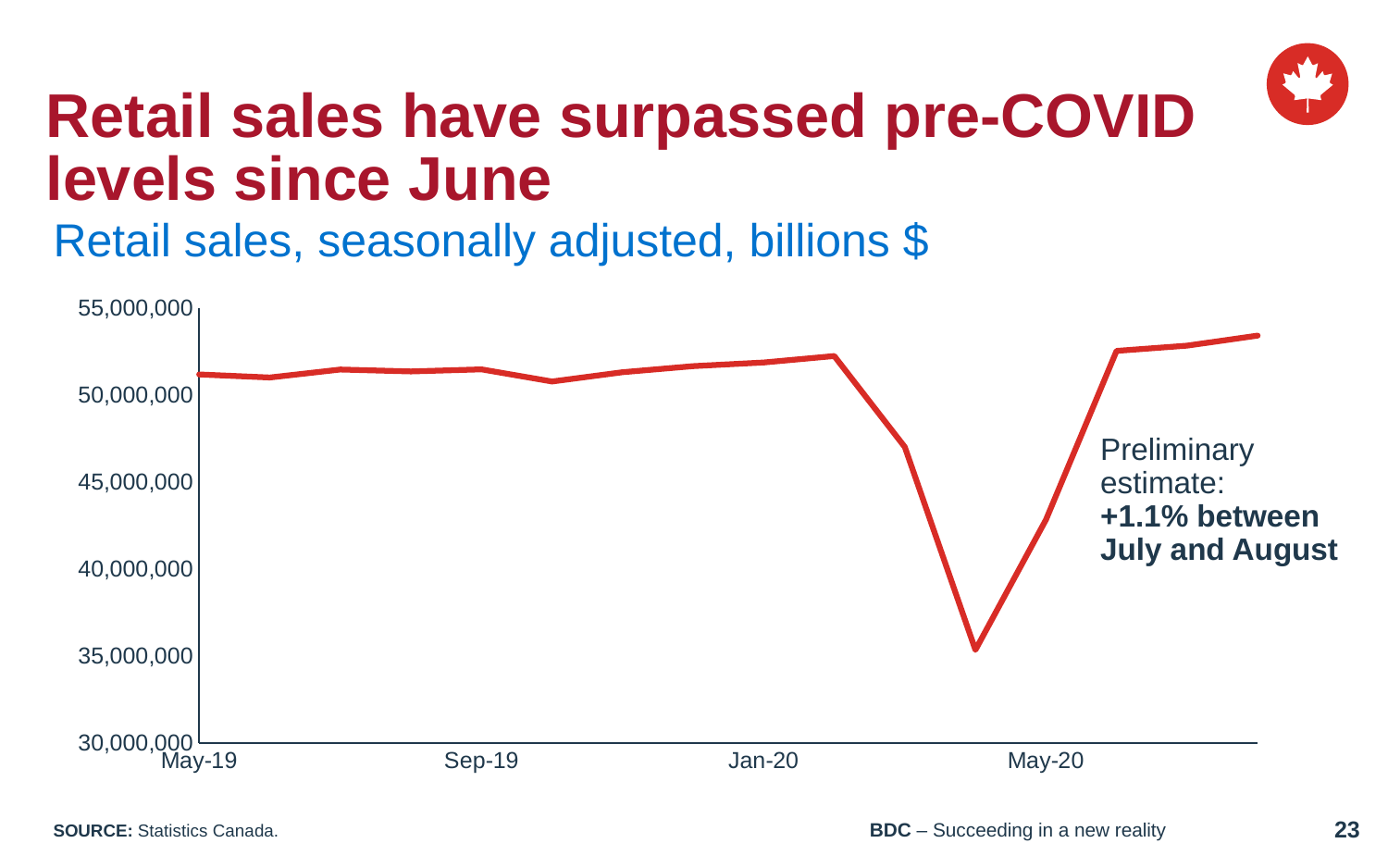
Does the line rise or fall between Jan-20 and its lowest point in spring 2020? fall What is the highest value shown on the y axis of the chart? 55,000,000 Is the value for Sep-19 greater or less than 50,000,000? greater Is the value for May-19 greater or less than 50,000,000? greater What is the title of the chart on the slide? Retail sales, seasonally adjusted, billions $ Is the value for May-20 greater or less than 50,000,000? less How many lines (series) are plotted on the chart? 1 What kind of chart is shown on the slide? line chart How many date labels are shown on the x axis of the chart? 4 Does the line rise or fall from its lowest point in spring 2020 to the end of the series? rise